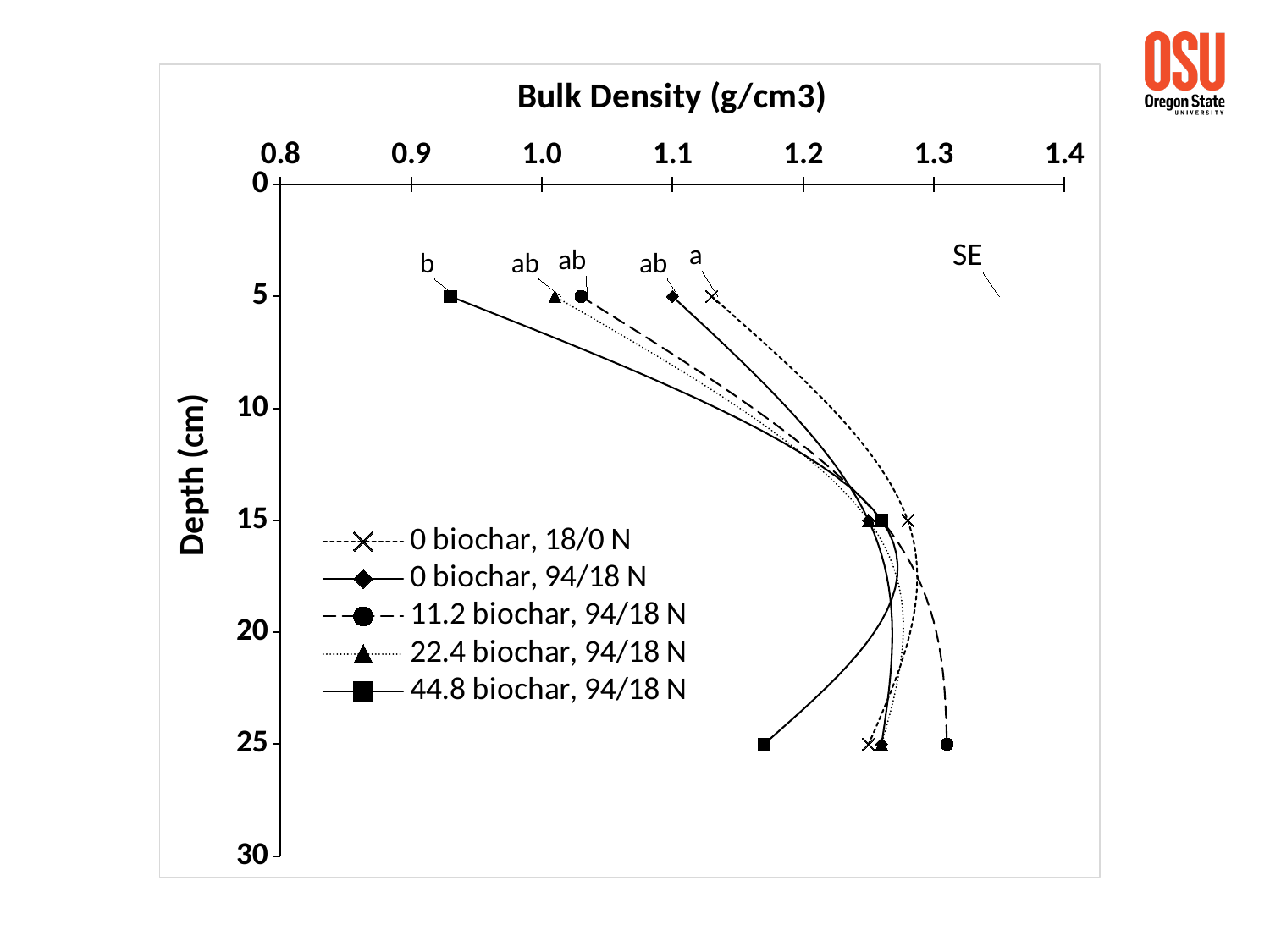
Which series has the highest bulk density at 25 cm depth? 11.2 biochar, 94/18 N What is the title of the chart? Bulk Density (g/cm3) At 25 cm depth, which has the larger bulk density: 11.2 biochar, 94/18 N or 44.8 biochar, 94/18 N? 11.2 biochar, 94/18 N What kind of chart is shown on the slide? line chart Which series is marked with the letter "b" at 5 cm depth? 44.8 biochar, 94/18 N At how many depths are data points plotted for each series? 3 Which series has the lowest bulk density at 5 cm depth? 44.8 biochar, 94/18 N Which series has the lowest bulk density at 25 cm depth? 44.8 biochar, 94/18 N Is the bulk density for 44.8 biochar, 94/18 N at 5 cm depth greater or less than 1.0? less How many series does the legend list? 5 Which series has the highest bulk density at 5 cm depth? 0 biochar, 18/0 N